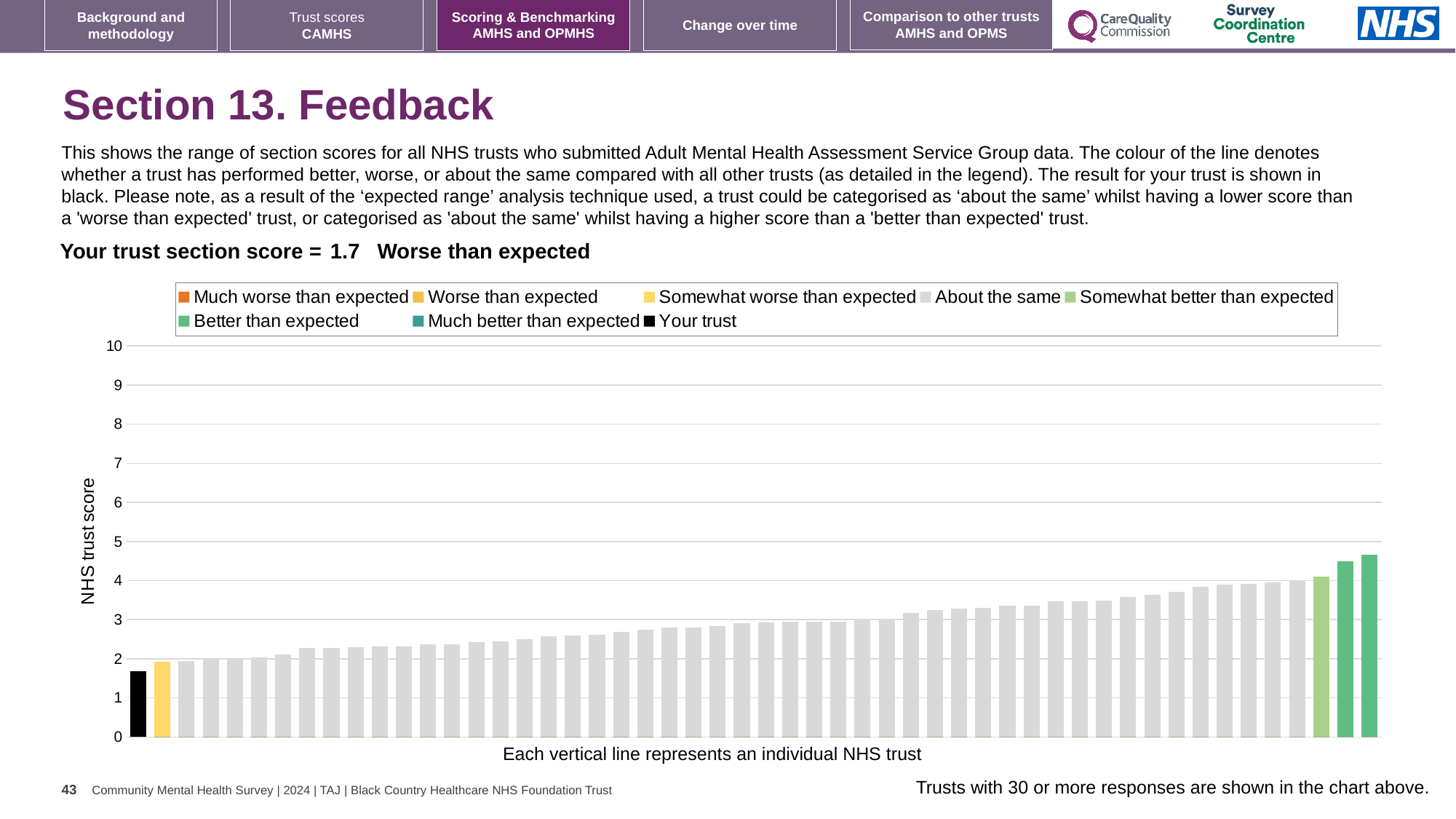
What colour is used for your trust's bar in the chart? black Do the bar values rise or fall from left to right across the chart? rise Is the value for your trust (the black bar) greater or less than 2? less How many entries does the chart legend list? 8 Is the value of the tallest bar in the chart greater or less than 5? less Which is larger: the black bar for your trust or the yellow bar immediately to its right? the yellow bar What is the section score for your trust shown on the slide? 1.7 What kind of chart is shown on the slide? bar chart Which bar in the chart is the lowest? Your trust (the black bar) Is the value of the tallest bar in the chart greater or less than 4? greater What is the label on the vertical axis of the chart? NHS trust score How is your trust's section score categorised on the slide? Worse than expected